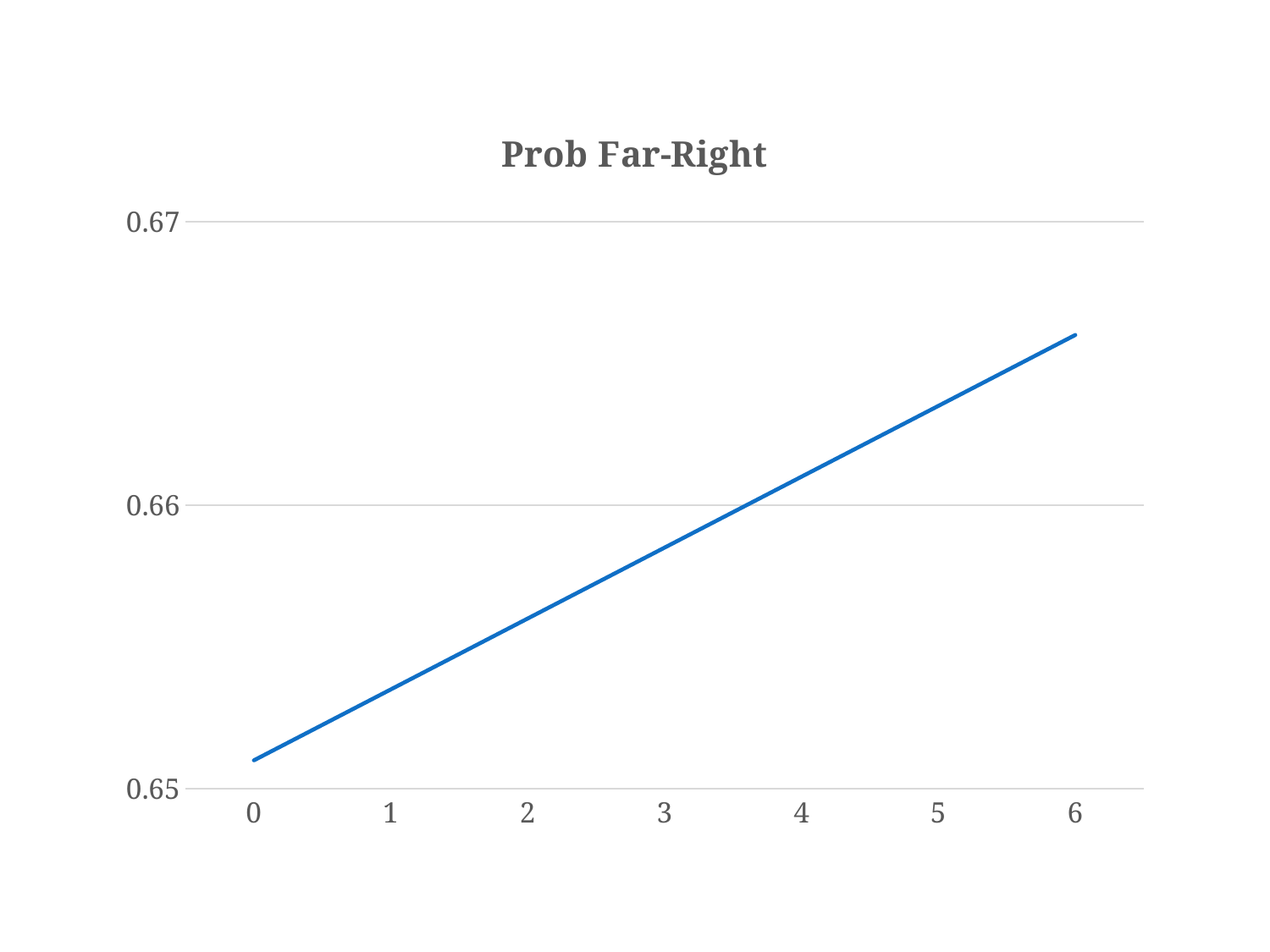
Which is larger, the value at x = 0 or the value at x = 6? x = 6 Does the line rise or fall as the x axis goes from 0 to 6? rise Is the value at x = 0 greater or less than 0.66? less What is the title of the chart? Prob Far-Right Is the value at x = 6 greater or less than 0.67? less At which x value does the line reach its highest point? 6 Is the value at x = 6 greater or less than 0.66? greater What kind of chart is shown on the slide? line chart How many tick labels are shown on the x axis? 7 At which x value does the line reach its lowest point? 0